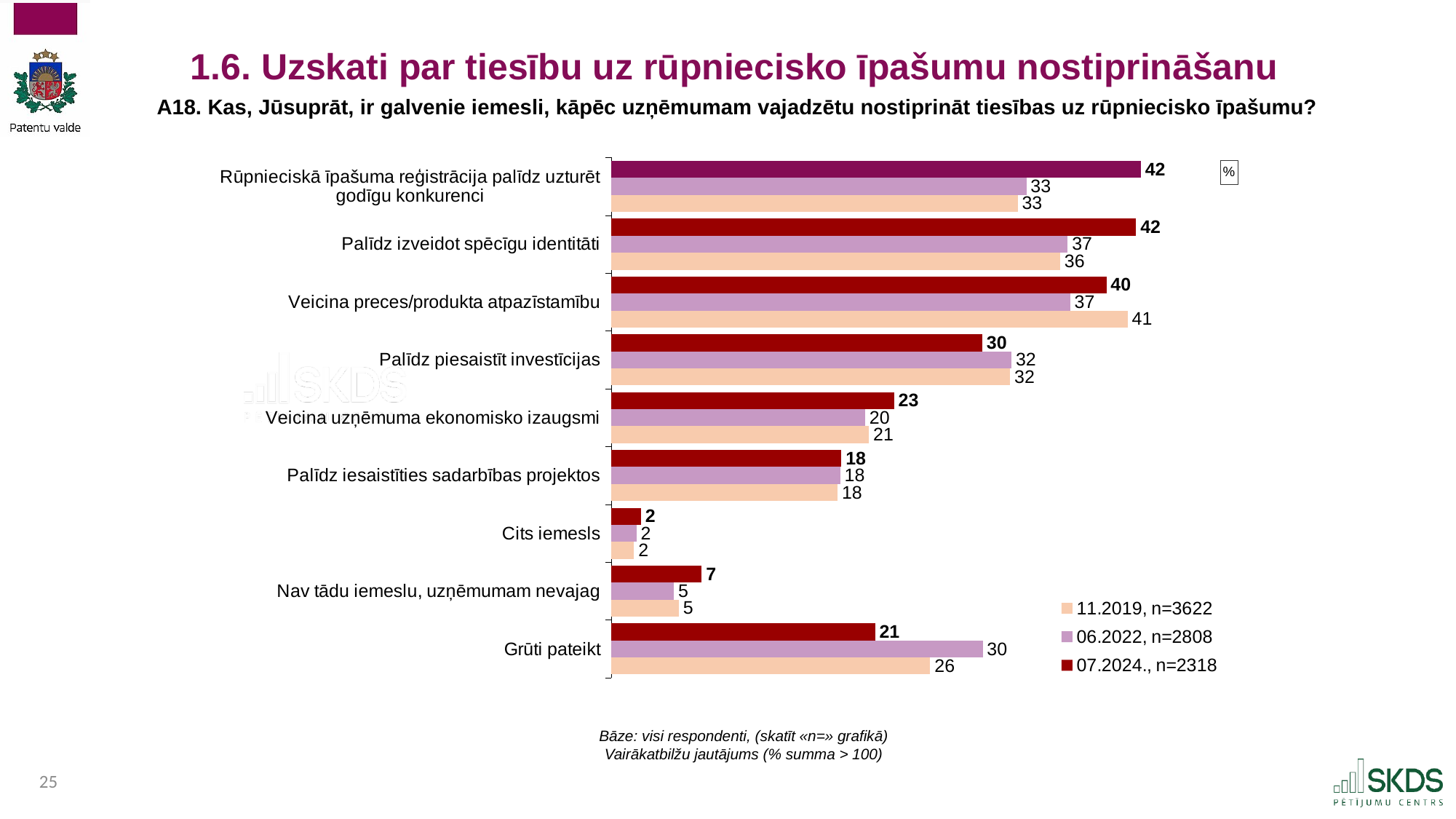
What kind of chart is shown on the slide? bar chart What is the value for 'Veicina preces/produkta atpazīstamību' in the 11.2019 survey? 41 How many categories (reasons) are shown in the chart? 9 What is the difference between the 06.2022 and 07.2024 values for 'Grūti pateikt'? 9 Which category has the lowest value in the 07.2024 survey? Cits iemesls What sample size (n) is given in the legend for the 07.2024 survey? n=2318 What is the value for 'Palīdz izveidot spēcīgu identitāti' in the 07.2024 survey? 42 What is the value for 'Rūpnieciskā īpašuma reģistrācija palīdz uzturēt godīgu konkurenci' in the 06.2022 survey? 33 For 'Nav tādu iemeslu, uzņēmumam nevajag', which survey has the larger value: 07.2024 or 11.2019? 07.2024 What is the value for 'Grūti pateikt' in the 06.2022 survey? 30 How many series does the legend list? 3 Which category has the highest value in the 11.2019 survey? Veicina preces/produkta atpazīstamību